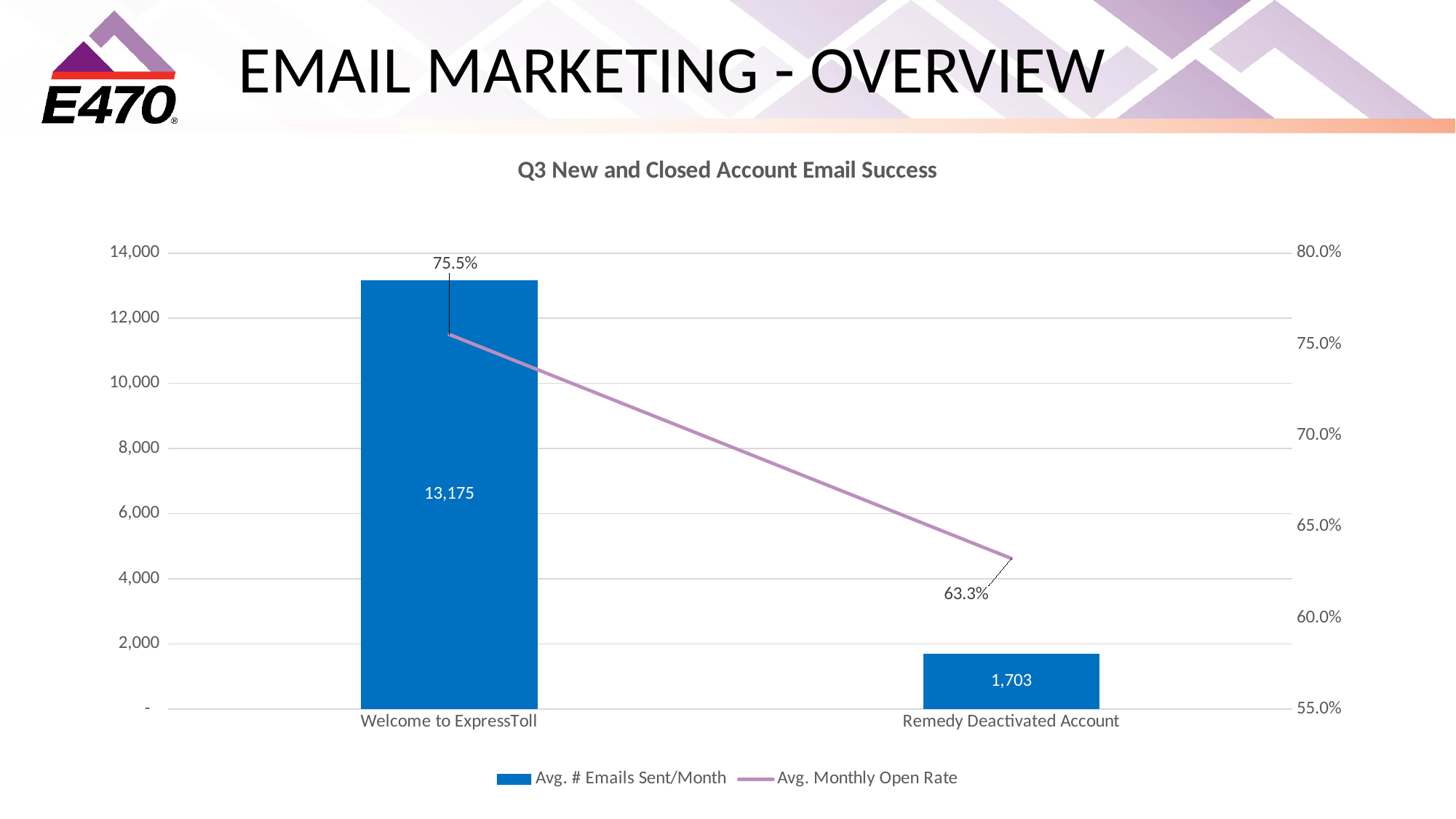
Which has a higher Avg. Monthly Open Rate, Welcome to ExpressToll or Remedy Deactivated Account? Welcome to ExpressToll What is the difference in Avg. Monthly Open Rate between Welcome to ExpressToll and Remedy Deactivated Account? 12.2% How many categories are shown on the x axis? 2 How many series does the legend list? 2 Which category has the lowest Avg. Monthly Open Rate? Remedy Deactivated Account What is the Avg. # Emails Sent/Month for Remedy Deactivated Account? 1,703 Which category has the highest Avg. # Emails Sent/Month? Welcome to ExpressToll What is the Avg. Monthly Open Rate for Remedy Deactivated Account? 63.3% What is the Avg. # Emails Sent/Month for Welcome to ExpressToll? 13,175 What is the title of the chart? Q3 New and Closed Account Email Success What is the difference in Avg. # Emails Sent/Month between Welcome to ExpressToll and Remedy Deactivated Account? 11,472 What is the Avg. Monthly Open Rate for Welcome to ExpressToll? 75.5%